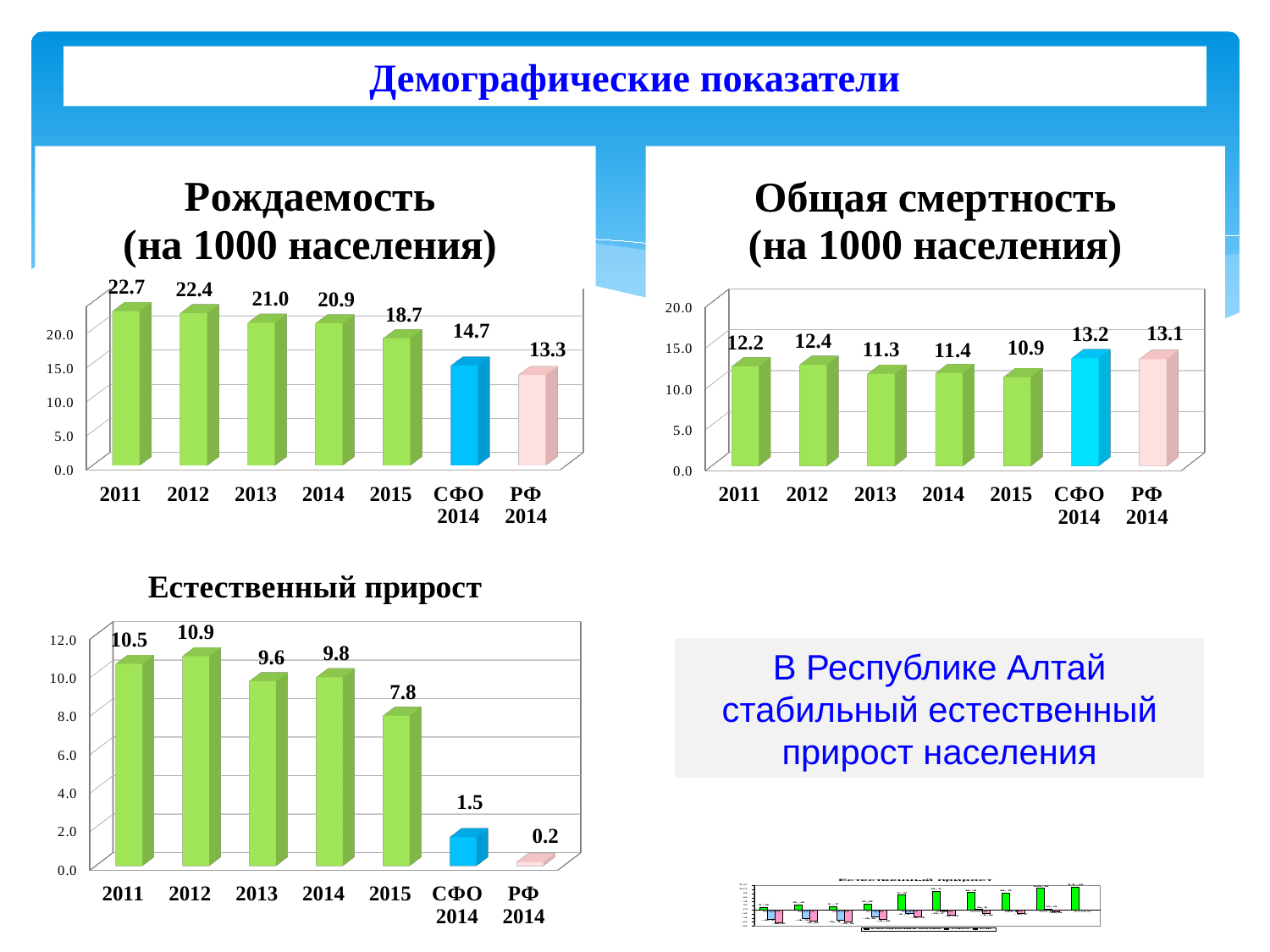
In the chart titled "Рождаемость (на 1000 населения)", which category has the lowest value? РФ 2014 In the chart titled "Рождаемость (на 1000 населения)", what is the difference between the values for 2011 and 2015? 4.0 In the chart titled "Естественный прирост", which category has the highest value? 2012 In the chart titled "Общая смертность (на 1000 населения)", what is the value for СФО 2014? 13.2 What type of chart is the chart titled "Естественный прирост"? Bar chart In the chart titled "Общая смертность (на 1000 населения)", which category has the lowest value? 2015 In the chart titled "Естественный прирост", what is the value for 2015? 7.8 In the chart titled "Рождаемость (на 1000 населения)", do the values rise or fall from 2011 to 2015? Fall In the chart titled "Общая смертность (на 1000 населения)", which is larger, the value for 2012 or the value for 2013? 2012 In the chart titled "Естественный прирост", what is the difference between the values for СФО 2014 and РФ 2014? 1.3 In the chart titled "Рождаемость (на 1000 населения)", how many bars are plotted? 7 In the chart titled "Рождаемость (на 1000 населения)", what is the value for 2011? 22.7